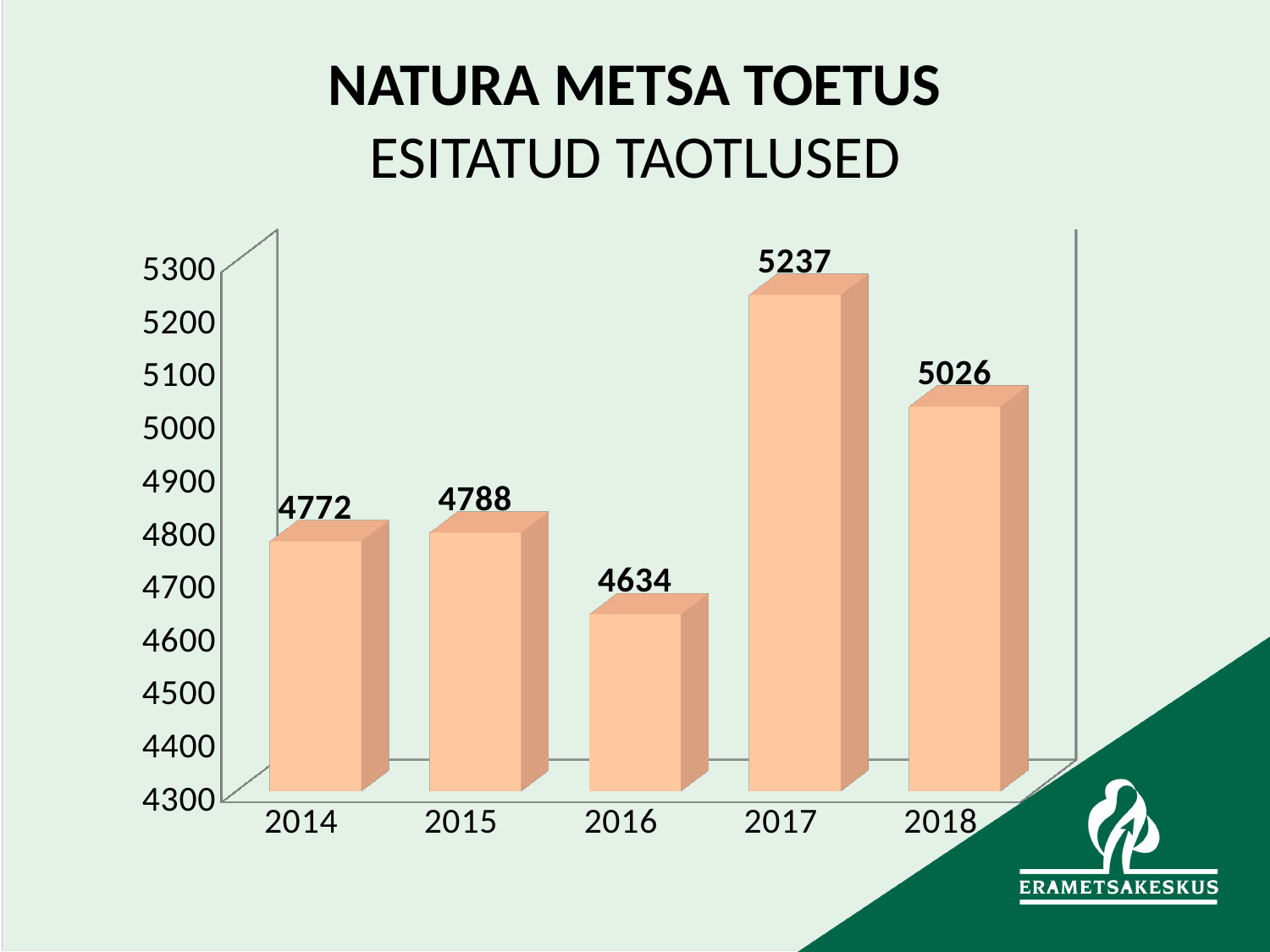
Which year has the highest value? 2017 What is the value for 2014? 4772 What is the value for 2016? 4634 What is the value for 2018? 5026 Which is larger, the value for 2017 or the value for 2018? 2017 Is the value for 2015 greater or less than 4700? greater What is the title of the chart? NATURA METSA TOETUS ESITATUD TAOTLUSED How many years are shown on the x axis? 5 What is the difference between the values for 2017 and 2016? 603 What is the difference between the values for 2018 and 2014? 254 What kind of chart is shown on the slide? bar chart Which year has the lowest value? 2016